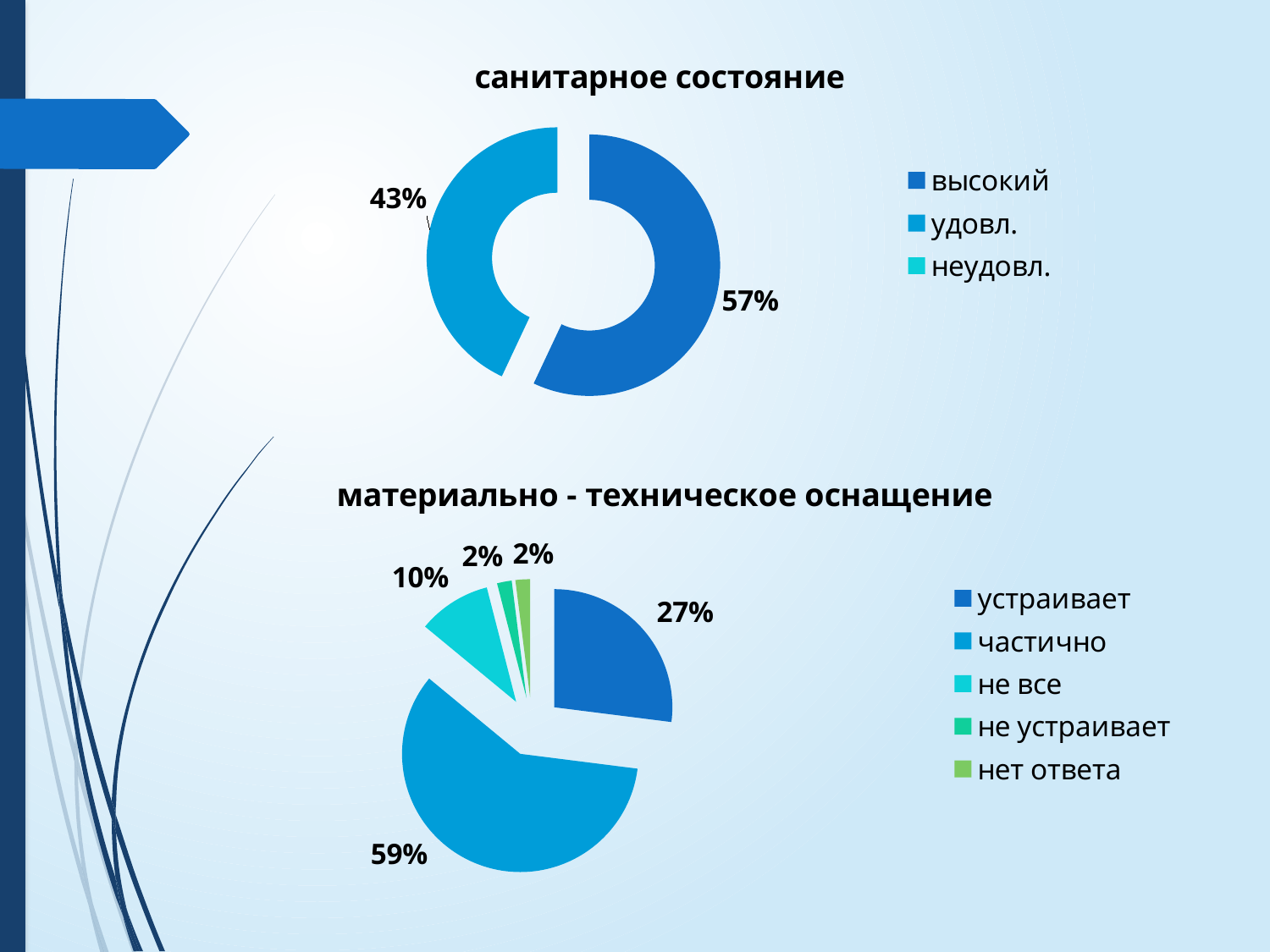
In the chart titled "материально - техническое оснащение", what percentage is shown for "не все"? 10% In the chart titled "санитарное состояние", what percentage is shown for "высокий"? 57% In the chart titled "материально - техническое оснащение", how many categories does the legend list? 5 In the chart titled "санитарное состояние", which category has the largest share? высокий In the chart titled "санитарное состояние", how many entries does the legend list? 3 In the chart titled "материально - техническое оснащение", what is the difference between the shares for "частично" and "устраивает"? 32% In the chart titled "санитарное состояние", what percentage is shown for "удовл."? 43% In the chart titled "санитарное состояние", what is the difference between the shares for "высокий" and "удовл."? 14% What kind of chart is the one titled "материально - техническое оснащение"? pie chart In the chart titled "материально - техническое оснащение", which category has the largest share? частично In the chart titled "материально - техническое оснащение", what percentage is shown for "устраивает"? 27% In the chart titled "материально - техническое оснащение", what percentage is shown for "частично"? 59%